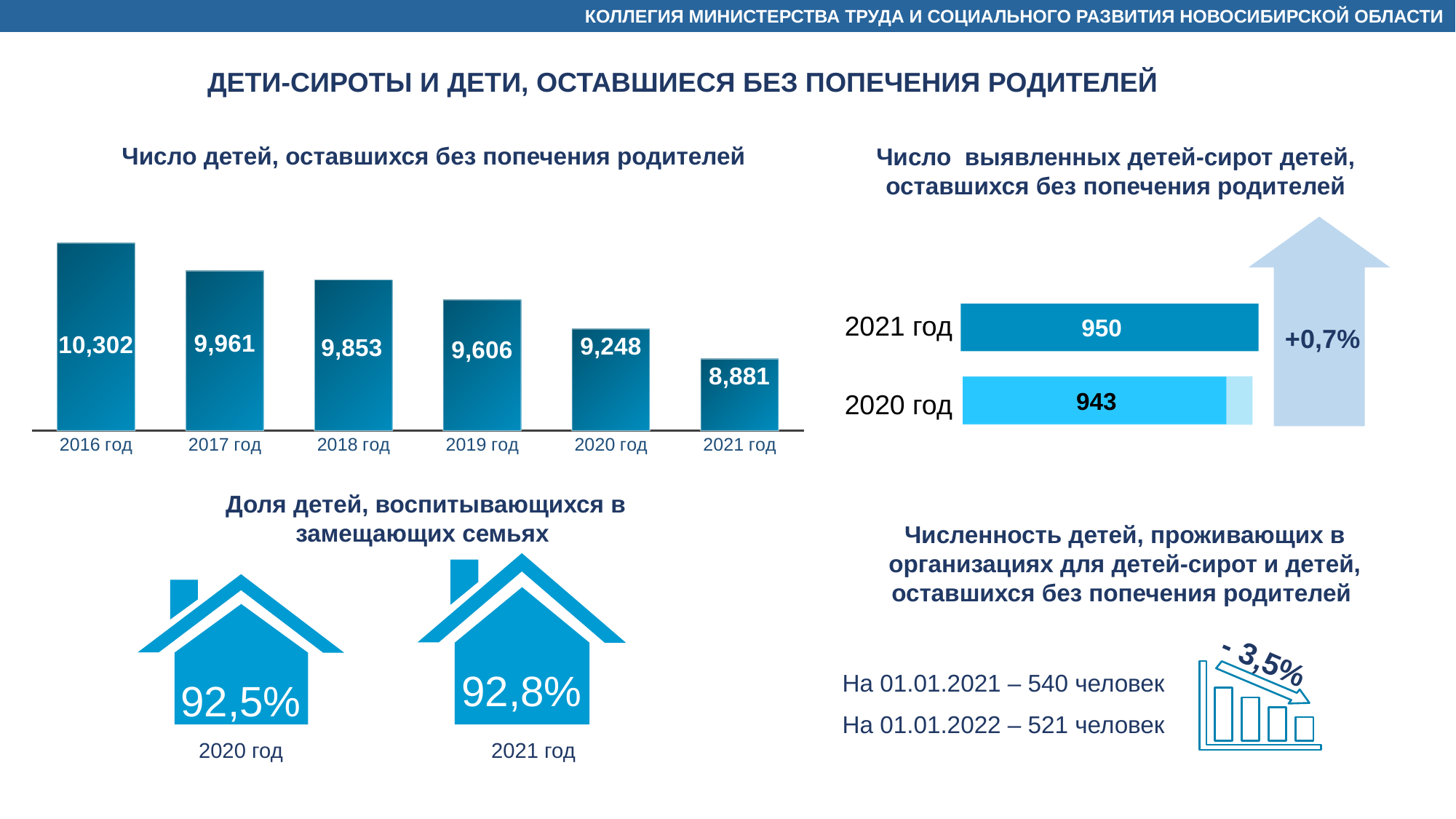
In the chart 'Число детей, оставшихся без попечения родителей', how many years are shown? 6 In the chart 'Число детей, оставшихся без попечения родителей', what is the value for 2016 год? 10,302 In the chart 'Число выявленных детей-сирот детей, оставшихся без попечения родителей', what is the value for 2020 год? 943 In the chart 'Число выявленных детей-сирот детей, оставшихся без попечения родителей', what is the value for 2021 год? 950 In the chart 'Число выявленных детей-сирот детей, оставшихся без попечения родителей', what percentage change is shown next to the arrow? +0,7% In the chart 'Число детей, оставшихся без попечения родителей', what is the value for 2019 год? 9,606 In the chart 'Число выявленных детей-сирот детей, оставшихся без попечения родителей', what is the difference between the 2021 and 2020 values? 7 In the chart 'Число детей, оставшихся без попечения родителей', which year has the highest value? 2016 год What kind of chart is 'Число детей, оставшихся без попечения родителей'? bar chart In the chart 'Число детей, оставшихся без попечения родителей', what is the difference between the values for 2020 год and 2021 год? 367 In the chart 'Число детей, оставшихся без попечения родителей', do the values rise or fall from 2016 to 2021? fall In the chart 'Число детей, оставшихся без попечения родителей', which year has the lowest value? 2021 год